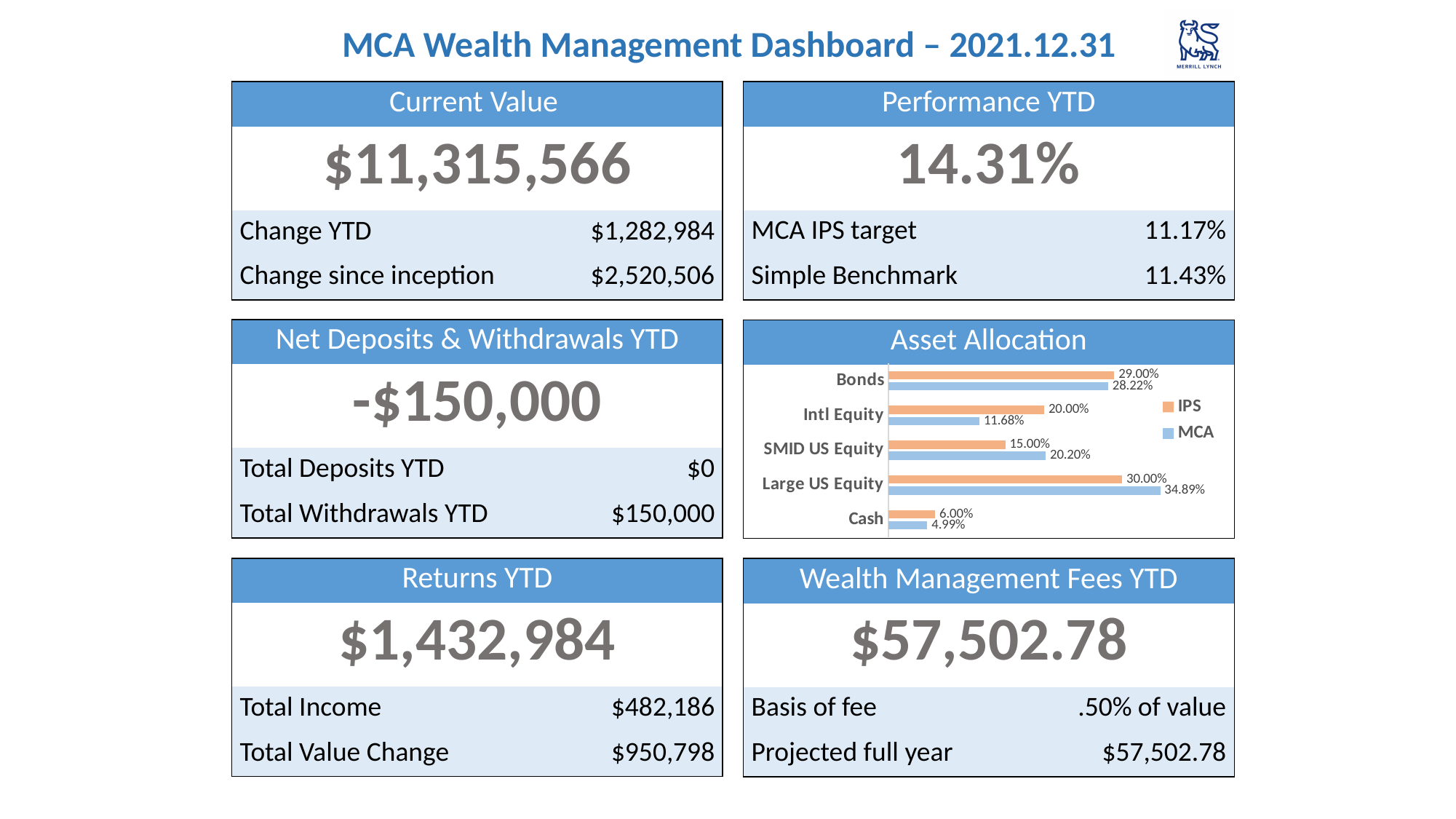
What type of chart is the Asset Allocation chart? bar chart How many series does the legend of the Asset Allocation chart list? 2 How many categories are shown in the Asset Allocation chart? 5 In the Asset Allocation chart, what is the MCA value for Large US Equity? 34.89% In the Asset Allocation chart, what is the IPS value for Cash? 6.00% In the Asset Allocation chart, is the IPS or MCA value larger for SMID US Equity? MCA In the Asset Allocation chart, which category has the highest MCA value? Large US Equity In the Asset Allocation chart, what is the MCA value for Intl Equity? 11.68% In the Asset Allocation chart, which category has the lowest IPS value? Cash In the Asset Allocation chart, what is the difference between the IPS and MCA values for Intl Equity? 8.32% In the Asset Allocation chart, what is the IPS value for Bonds? 29.00% In the Asset Allocation chart, which series is shown in orange? IPS